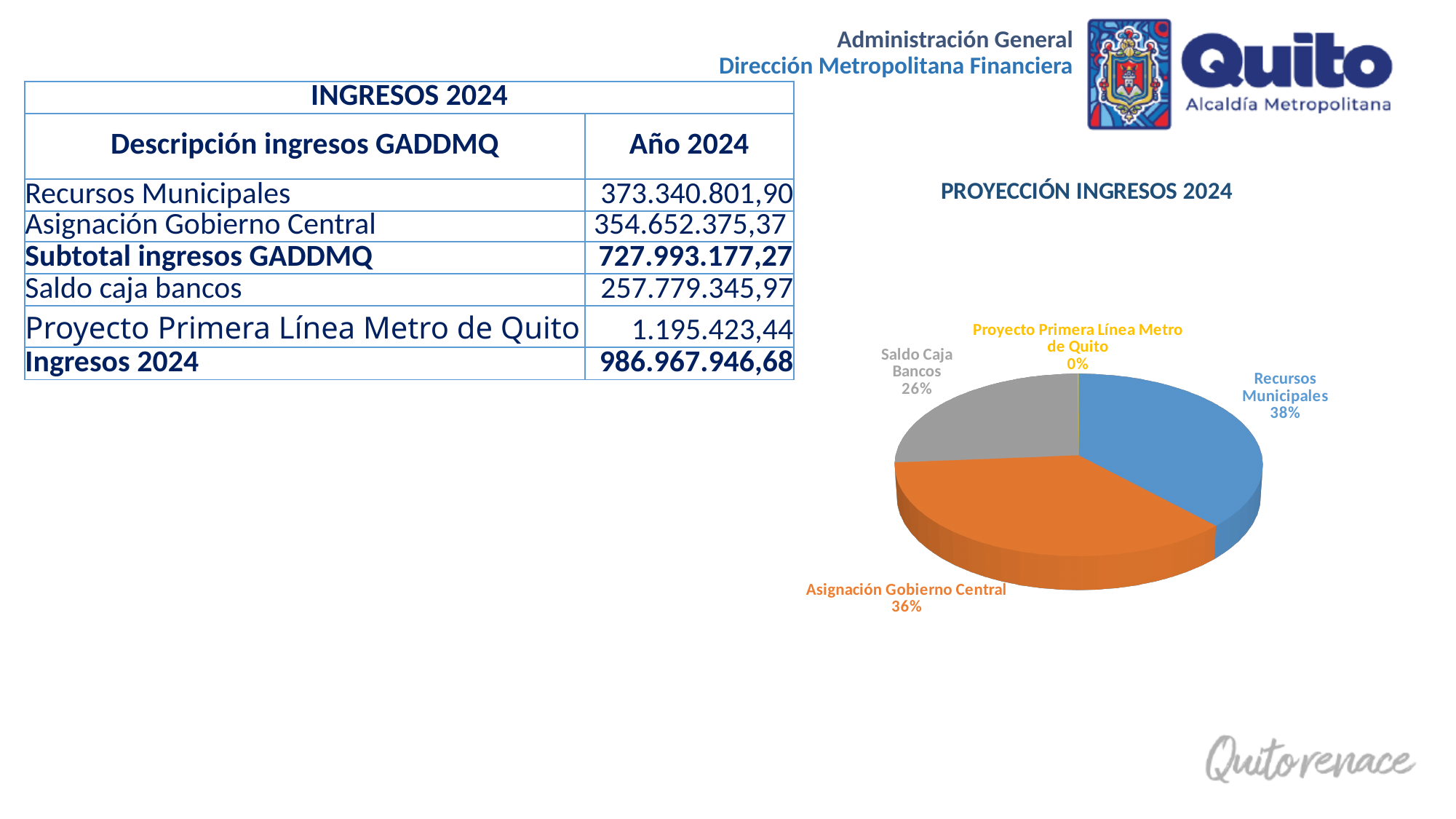
In the pie chart, what share is labelled for Asignación Gobierno Central? 36% Which slice of the pie chart has the largest share? Recursos Municipales In the pie chart, which is larger: the share for Asignación Gobierno Central or the share for Saldo Caja Bancos? Asignación Gobierno Central In the pie chart, what is the difference in percentage points between Recursos Municipales and Saldo Caja Bancos? 12 percentage points In the pie chart, what share is labelled for Saldo Caja Bancos? 26% In the pie chart, what share is labelled for Proyecto Primera Línea Metro de Quito? 0% What colour is the Asignación Gobierno Central slice in the pie chart? Orange Which slice of the pie chart has the smallest share? Proyecto Primera Línea Metro de Quito What is the title of the pie chart on the slide? PROYECCIÓN INGRESOS 2024 What kind of chart is shown under the title PROYECCIÓN INGRESOS 2024? Pie chart How many slices are labelled in the pie chart? 4